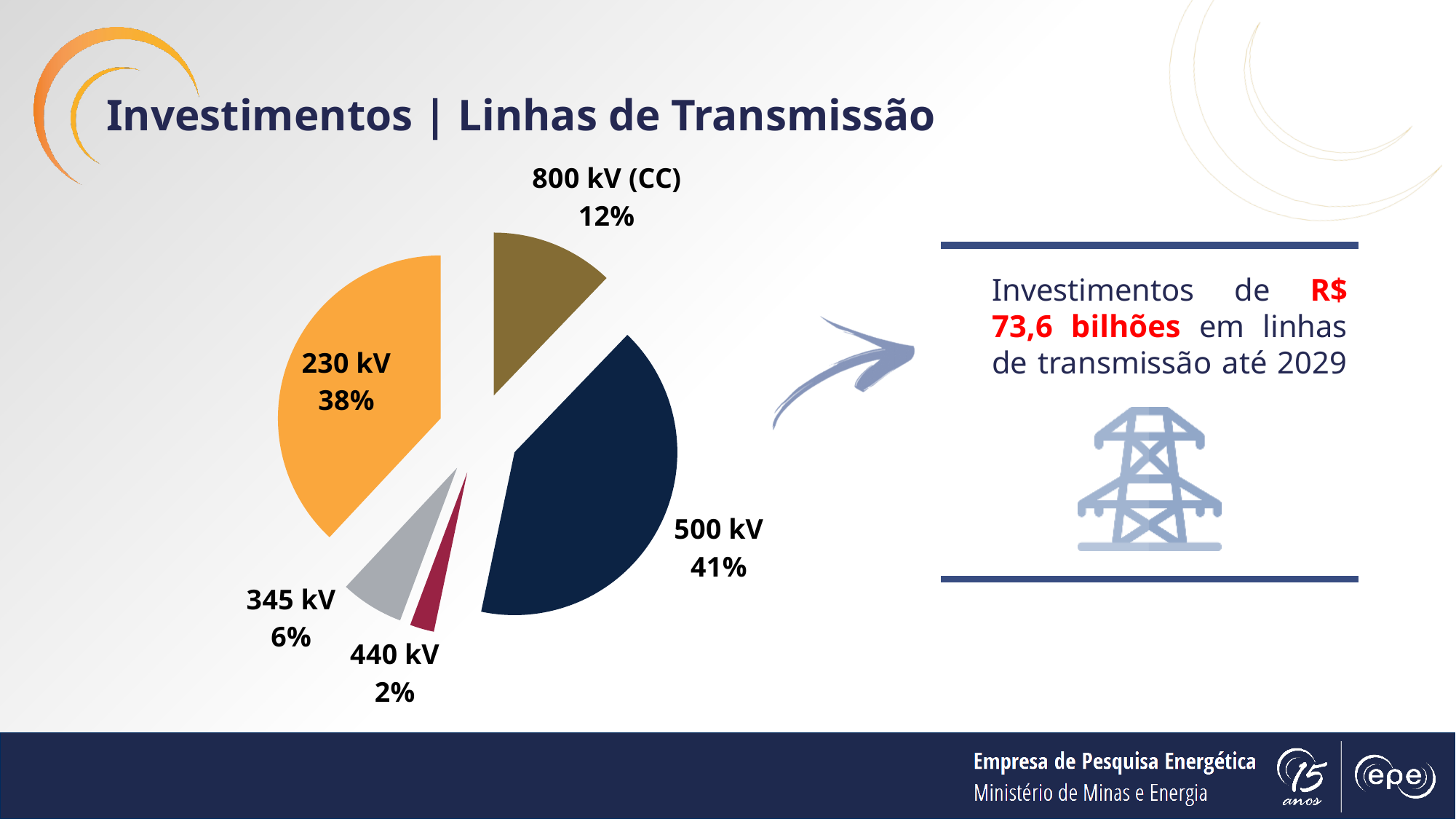
What kind of chart is shown on the slide? Pie chart What is the value shown for 800 kV (CC)? 12% What is the difference in percentage points between 500 kV and 230 kV? 3% What share of the pie does 500 kV represent? 41% Which category has the smallest slice of the pie? 440 kV Which category has the largest slice of the pie? 500 kV What is the difference in percentage points between 800 kV (CC) and 345 kV? 6% What is the value shown for 440 kV? 2% How many categories are shown in the pie chart? 5 Which is larger, the share for 345 kV or the share for 440 kV? 345 kV What is the value shown for 345 kV? 6% What share of the pie does 230 kV represent? 38%